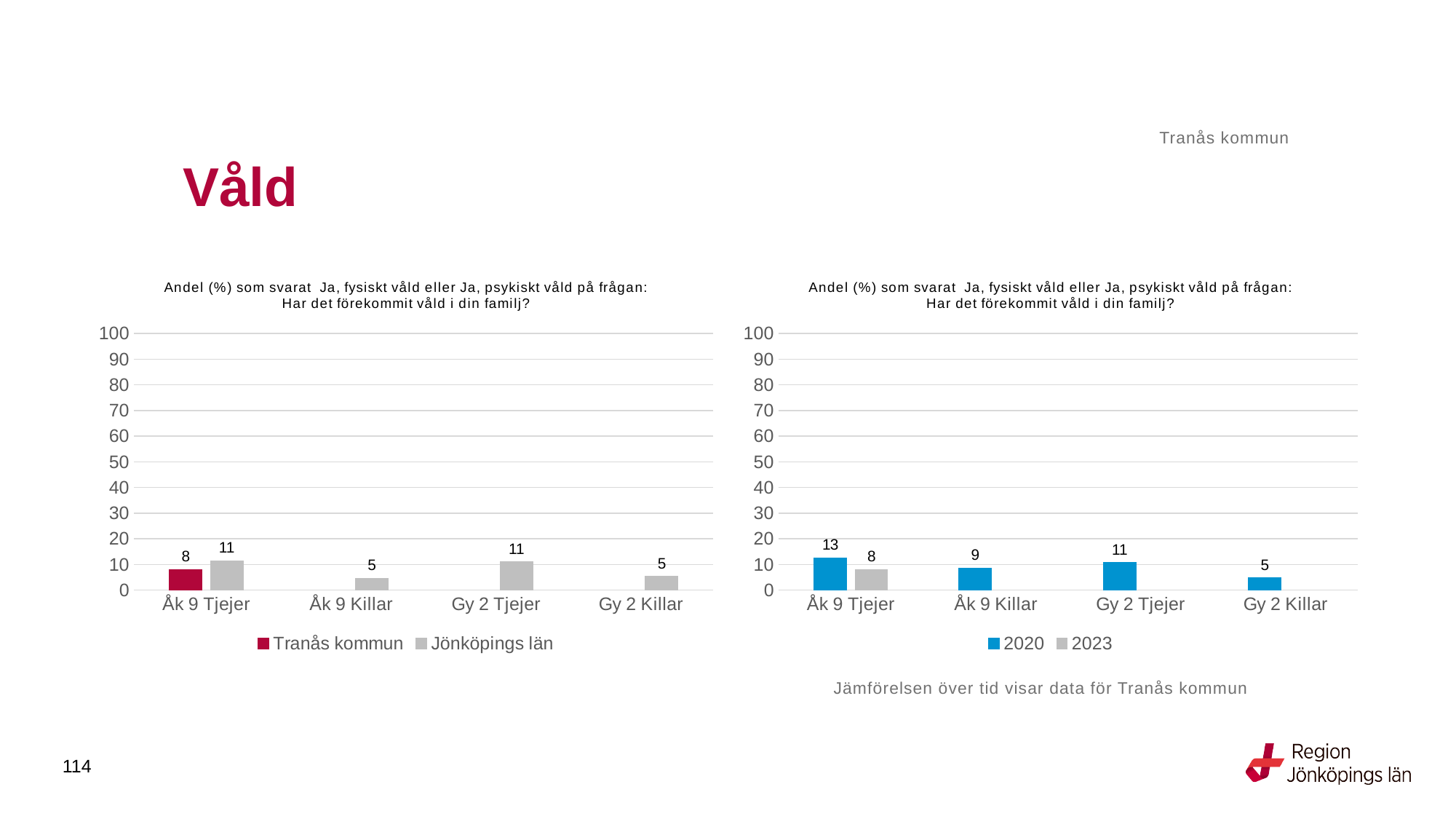
In the right chart, what is the value for 2020 for Åk 9 Tjejer? 13 In the right chart, which category has the lowest value for 2020? Gy 2 Killar In the left chart, what is the value for Jönköpings län for Gy 2 Tjejer? 11 In the left chart, what is the difference between Jönköpings län and Tranås kommun for Åk 9 Tjejer? 3 In the left chart, what is the value for Jönköpings län for Åk 9 Killar? 5 In the right chart, what is the value for 2023 for Åk 9 Tjejer? 8 In the right chart, which category has the highest value for 2020? Åk 9 Tjejer In the left chart, what is the value for Tranås kommun for Åk 9 Tjejer? 8 In the left chart, how many series does the legend list? 2 In the right chart, what is the difference between the 2020 and 2023 values for Åk 9 Tjejer? 5 What kind of chart is the right chart? Bar chart In the right chart, is the 2020 value for Gy 2 Tjejer greater or less than 20? less